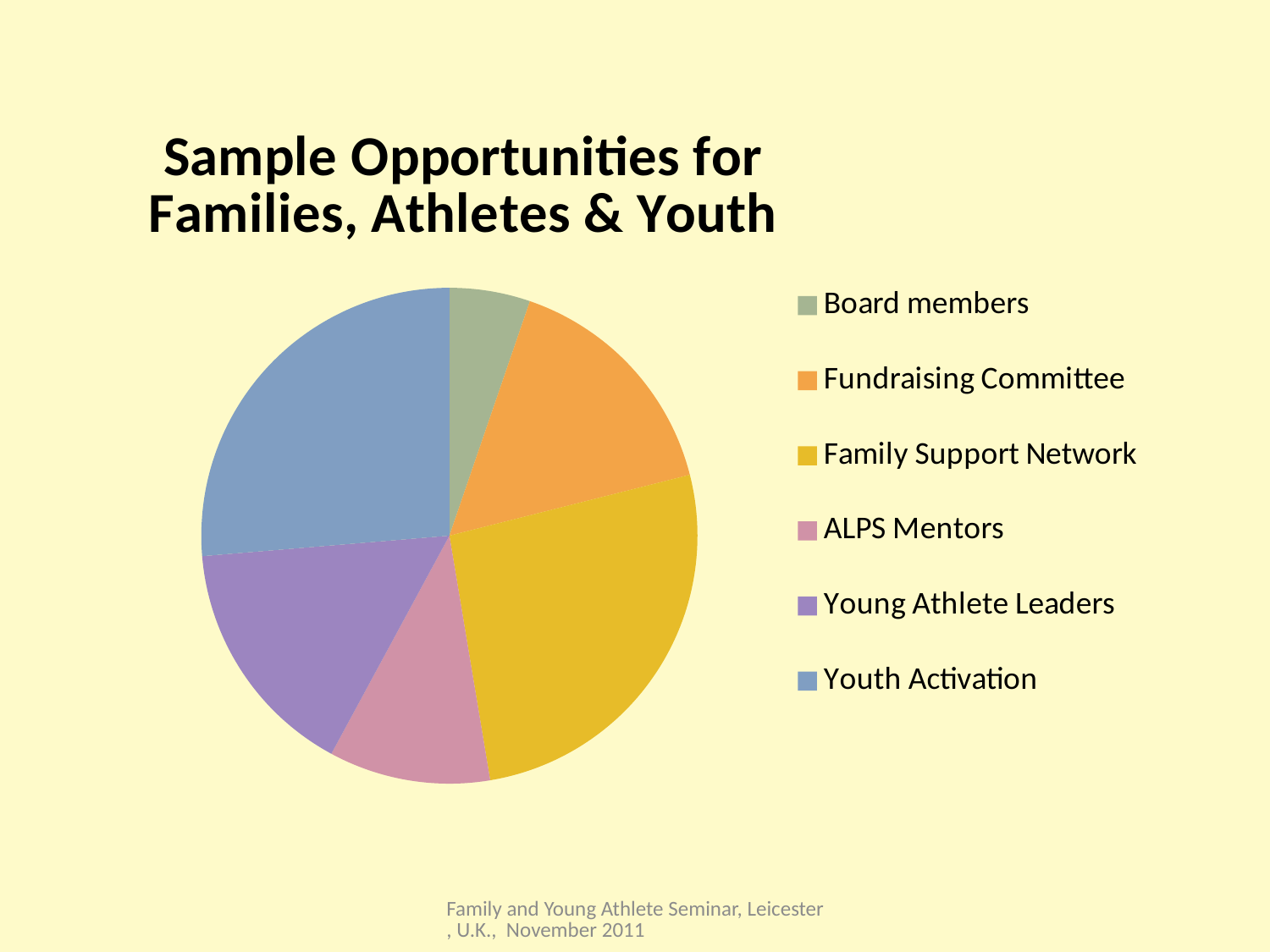
How many entries does the legend list? 6 Which slice is larger, Board members or Fundraising Committee? Fundraising Committee How many categories (slices) does the pie chart have? 6 Which category has the smallest slice of the pie? Board members What is the title of the slide containing the pie chart? Sample Opportunities for Families, Athletes & Youth Which slice is larger, ALPS Mentors or Young Athlete Leaders? Young Athlete Leaders Which slice is larger, Fundraising Committee or ALPS Mentors? Fundraising Committee What kind of chart is shown on the slide? pie chart Which category is shown in blue in the pie chart? Youth Activation